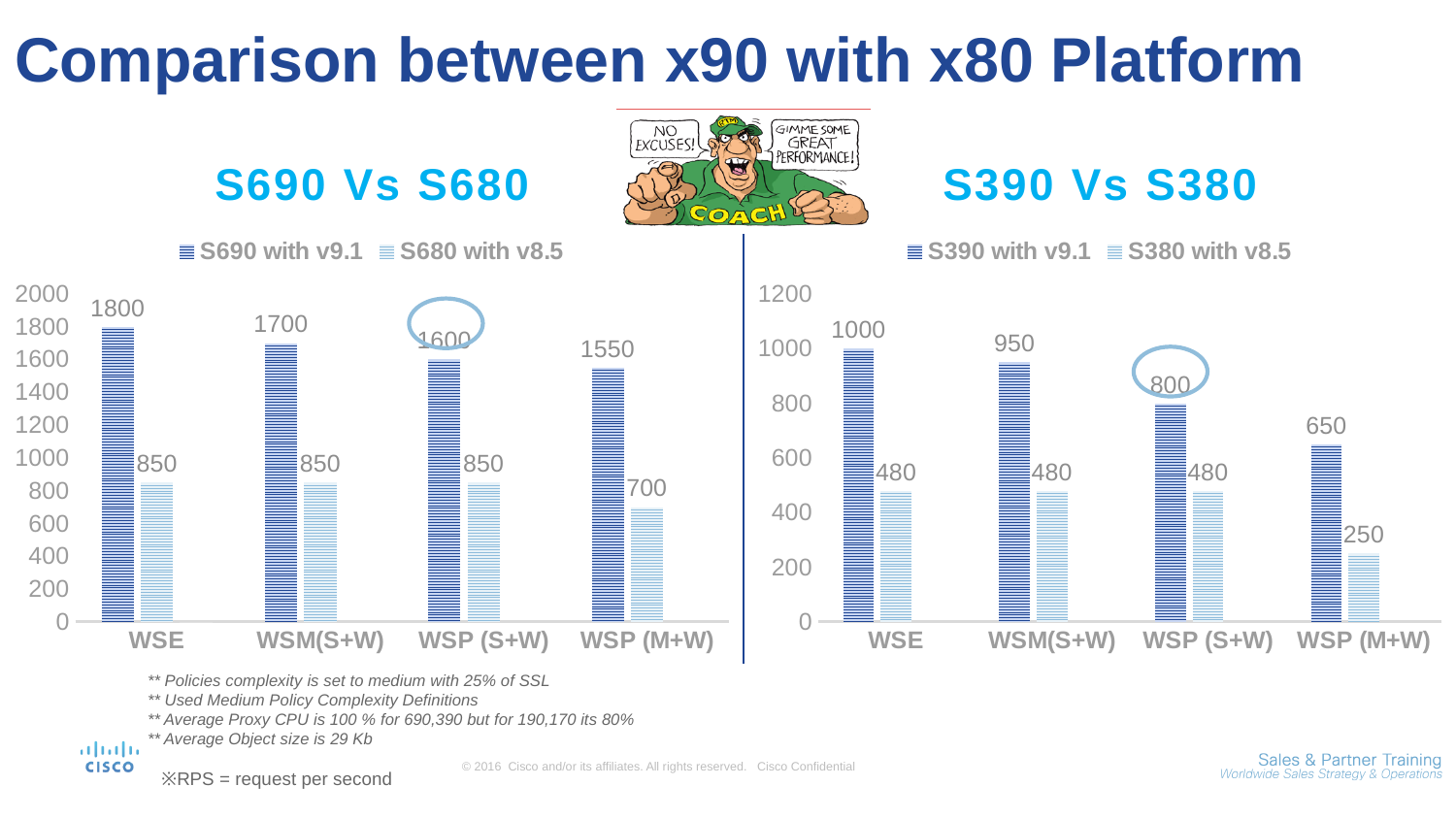
How many categories are shown on the x axis of the S690 Vs S680 chart? 4 What kind of chart is the S690 Vs S680 chart? Bar chart In the S390 Vs S380 chart, what is the difference between S390 with v9.1 and S380 with v8.5 at WSE? 520 In the S390 Vs S380 chart, what is the value for S390 with v9.1 at WSP (S+W)? 800 In the S690 Vs S680 chart, what is the value for S680 with v8.5 at WSP (M+W)? 700 In the S690 Vs S680 chart, what is the difference between S690 with v9.1 and S680 with v8.5 at WSM(S+W)? 850 In the S390 Vs S380 chart, which category has the lowest value for S380 with v8.5? WSP (M+W) In the S690 Vs S680 chart, what is the value for S690 with v9.1 at WSE? 1800 In the S690 Vs S680 chart, which category has the highest value for S690 with v9.1? WSE In the S390 Vs S380 chart, what is the value for S380 with v8.5 at WSP (M+W)? 250 How many series does the legend of the S390 Vs S380 chart list? 2 In the S390 Vs S380 chart, which is larger at WSP (M+W): S390 with v9.1 or S380 with v8.5? S390 with v9.1